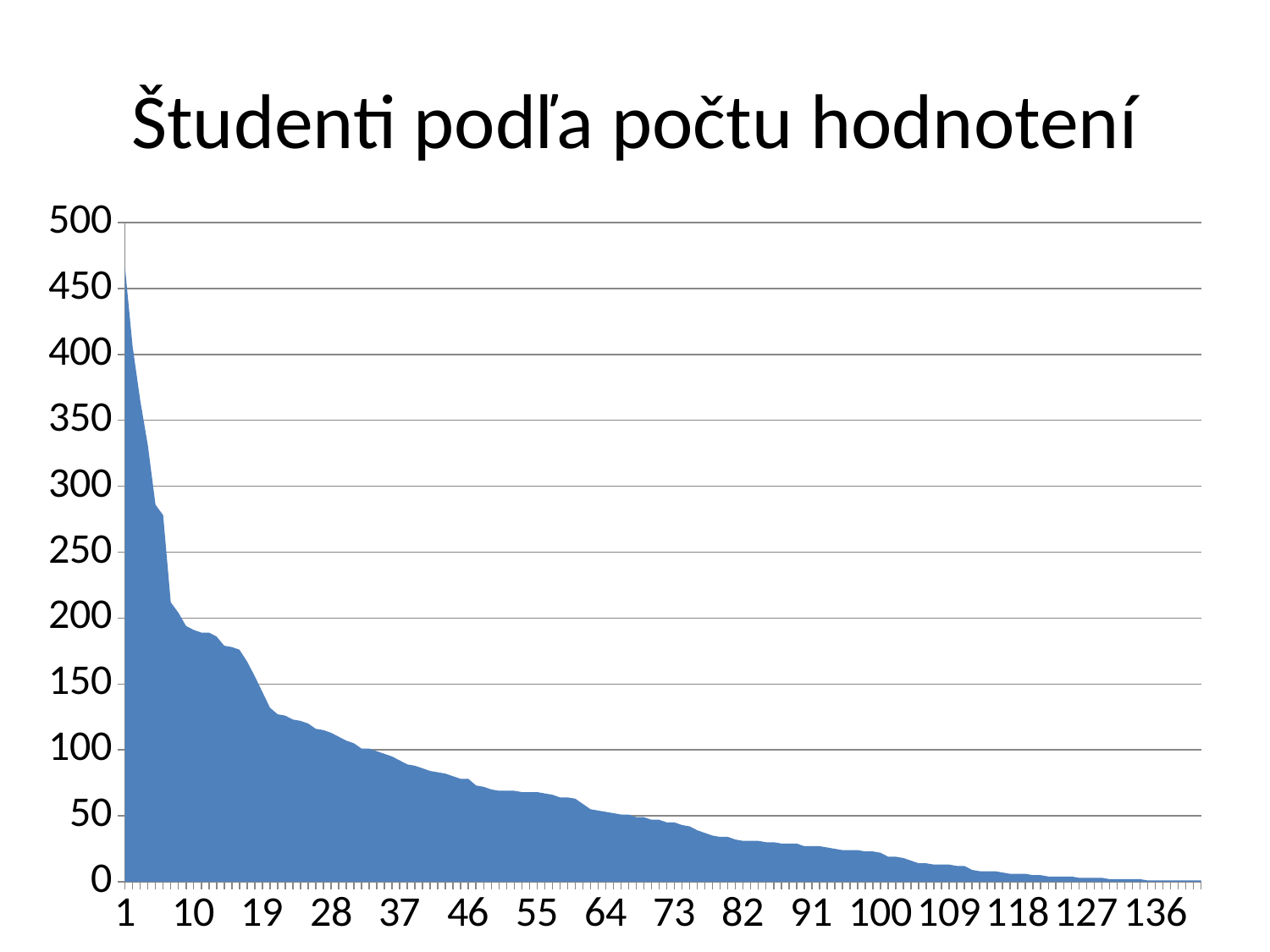
Do the values rise or fall as you move along the x axis from 1 to 136? fall At which x-axis category is the value highest? 1 What is the title of the chart? Študenti podľa počtu hodnotení Is the value at category 136 greater or less than 50? less Is the value at category 1 greater or less than 400? greater Is the value at category 100 greater or less than 50? less What kind of chart is shown on the slide? area chart What is the highest value shown on the y axis? 500 Which has the larger value, category 28 or category 91? 28 Which has the larger value, category 10 or category 64? 10